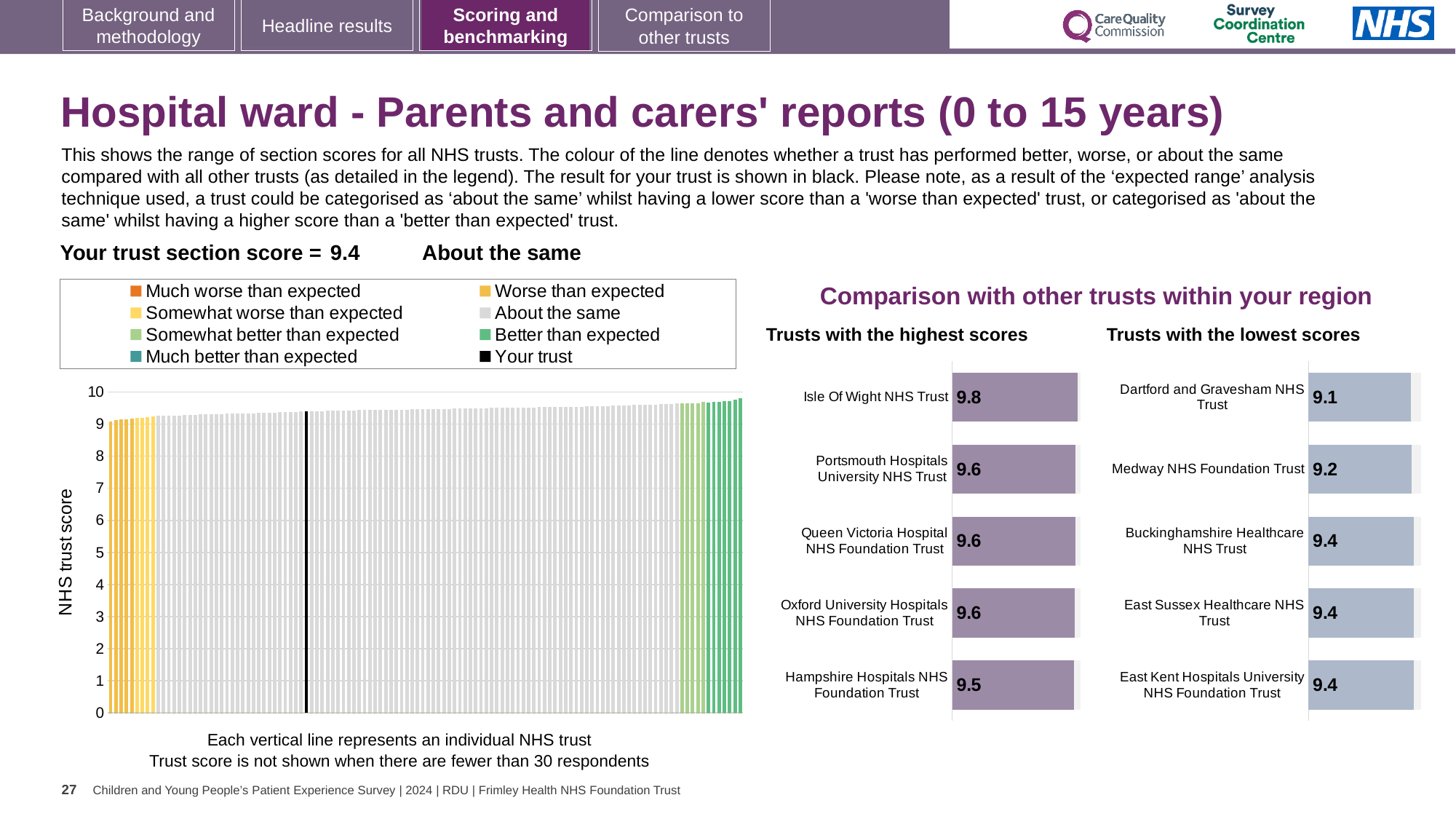
How many entries does the legend of the 'NHS trust score' chart on the left list? 8 In the 'Trusts with the lowest scores' chart, which has the larger score: Dartford and Gravesham NHS Trust or Medway NHS Foundation Trust? Medway NHS Foundation Trust In the 'NHS trust score' chart on the left, what is the label of the vertical axis? NHS trust score In the 'Trusts with the lowest scores' chart, which trust has the lowest score? Dartford and Gravesham NHS Trust In the 'Trusts with the lowest scores' chart, what is the score for Medway NHS Foundation Trust? 9.2 In the 'Trusts with the highest scores' chart, which trust has the highest score? Isle Of Wight NHS Trust How many trusts are shown in the 'Trusts with the lowest scores' chart? 5 How many trusts are shown in the 'Trusts with the highest scores' chart? 5 What kind of chart is the 'NHS trust score' chart on the left of the slide? Bar chart In the 'Trusts with the highest scores' chart, what is the difference between the scores of Isle Of Wight NHS Trust and Hampshire Hospitals NHS Foundation Trust? 0.3 In the 'Trusts with the highest scores' chart, what is the score for Isle Of Wight NHS Trust? 9.8 In the 'NHS trust score' chart on the left, is the value for the black bar (your trust) greater or less than 9? greater